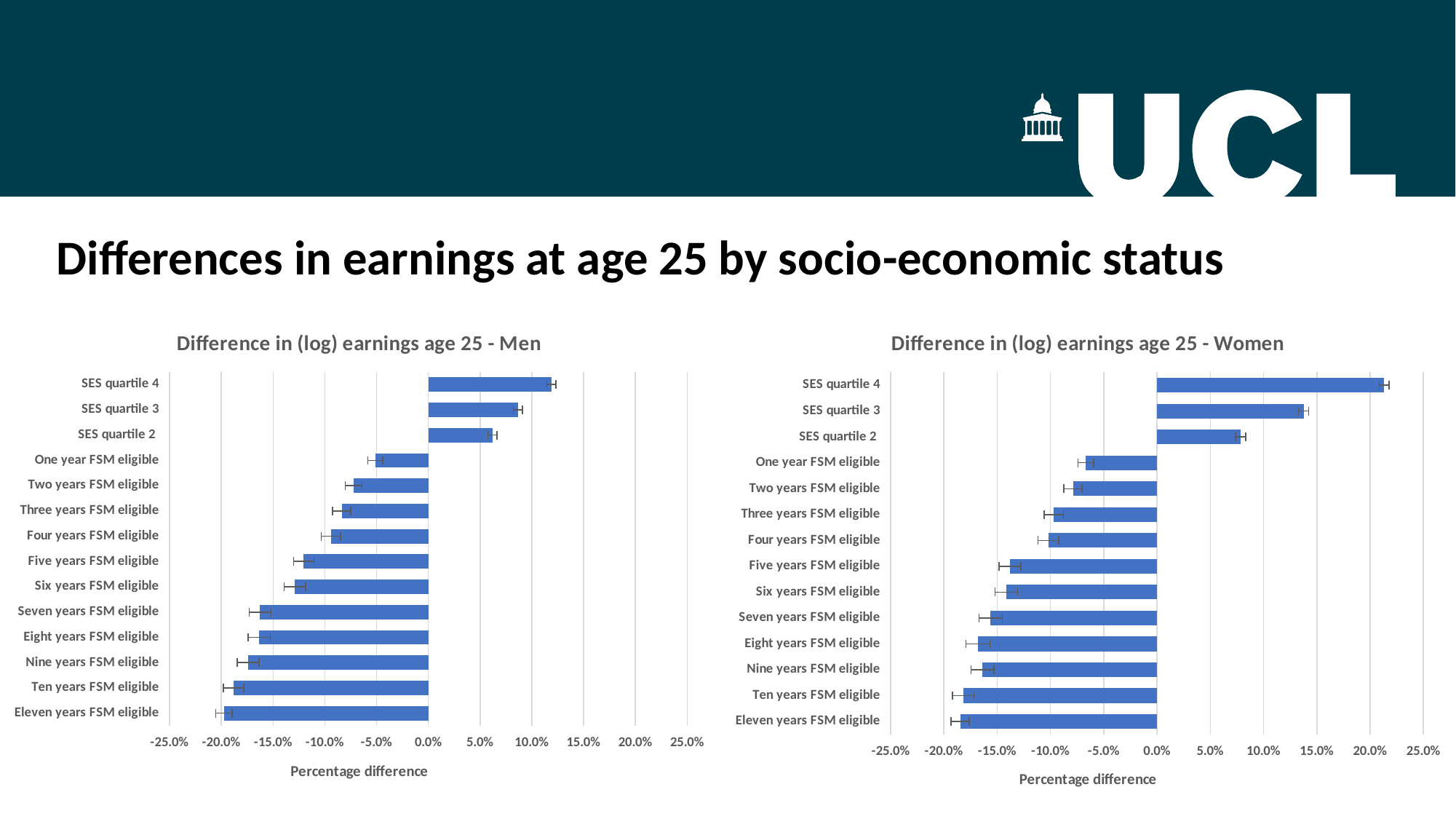
In the 'Difference in (log) earnings age 25 - Men' chart, how many categories are plotted? 14 In the 'Difference in (log) earnings age 25 - Men' chart, which category has the highest value? SES quartile 4 In the 'Difference in (log) earnings age 25 - Women' chart, how many categories are plotted? 14 In the 'Difference in (log) earnings age 25 - Men' chart, is the value for Five years FSM eligible greater or less than -10.0%? less In the 'Difference in (log) earnings age 25 - Women' chart, is the value for One year FSM eligible greater or less than -10.0%? greater In the 'Difference in (log) earnings age 25 - Men' chart, which is larger, the value for Three years FSM eligible or Seven years FSM eligible? Three years FSM eligible In the 'Difference in (log) earnings age 25 - Women' chart, which is larger, the value for SES quartile 3 or SES quartile 2? SES quartile 3 In the 'Difference in (log) earnings age 25 - Men' chart, what kind of chart is used? Bar chart In the 'Difference in (log) earnings age 25 - Women' chart, is the value for SES quartile 4 greater or less than 20.0%? greater What is the x-axis title of the 'Difference in (log) earnings age 25 - Women' chart? Percentage difference In the 'Difference in (log) earnings age 25 - Women' chart, which category has the highest value? SES quartile 4